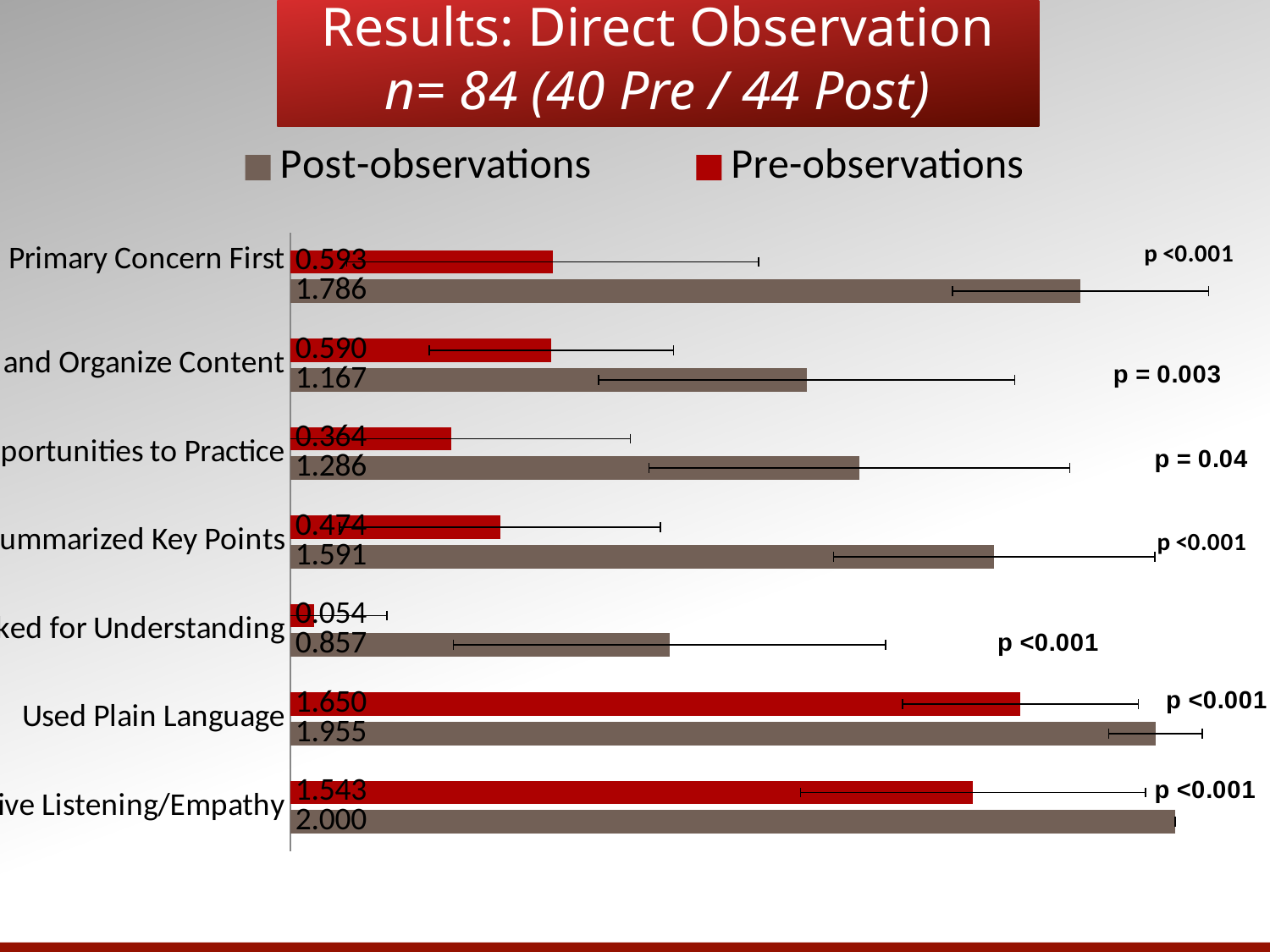
How many categories are plotted on the chart? 7 What kind of chart is shown on the slide? Bar chart What is the highest Post-observations value shown on the chart? 2.000 How many series does the legend list? 2 What is the Pre-observations value for Primary Concern First? 0.593 What is the lowest Pre-observations value shown on the chart? 0.054 What is the difference between the Post-observations and Pre-observations values for Primary Concern First? 1.193 What is the Post-observations value for Used Plain Language? 1.955 What is the Post-observations value for Primary Concern First? 1.786 What is the difference between the Post-observations and Pre-observations values for Used Plain Language? 0.305 Which has the larger Pre-observations value, Used Plain Language or Primary Concern First? Used Plain Language What is the Pre-observations value for Used Plain Language? 1.650